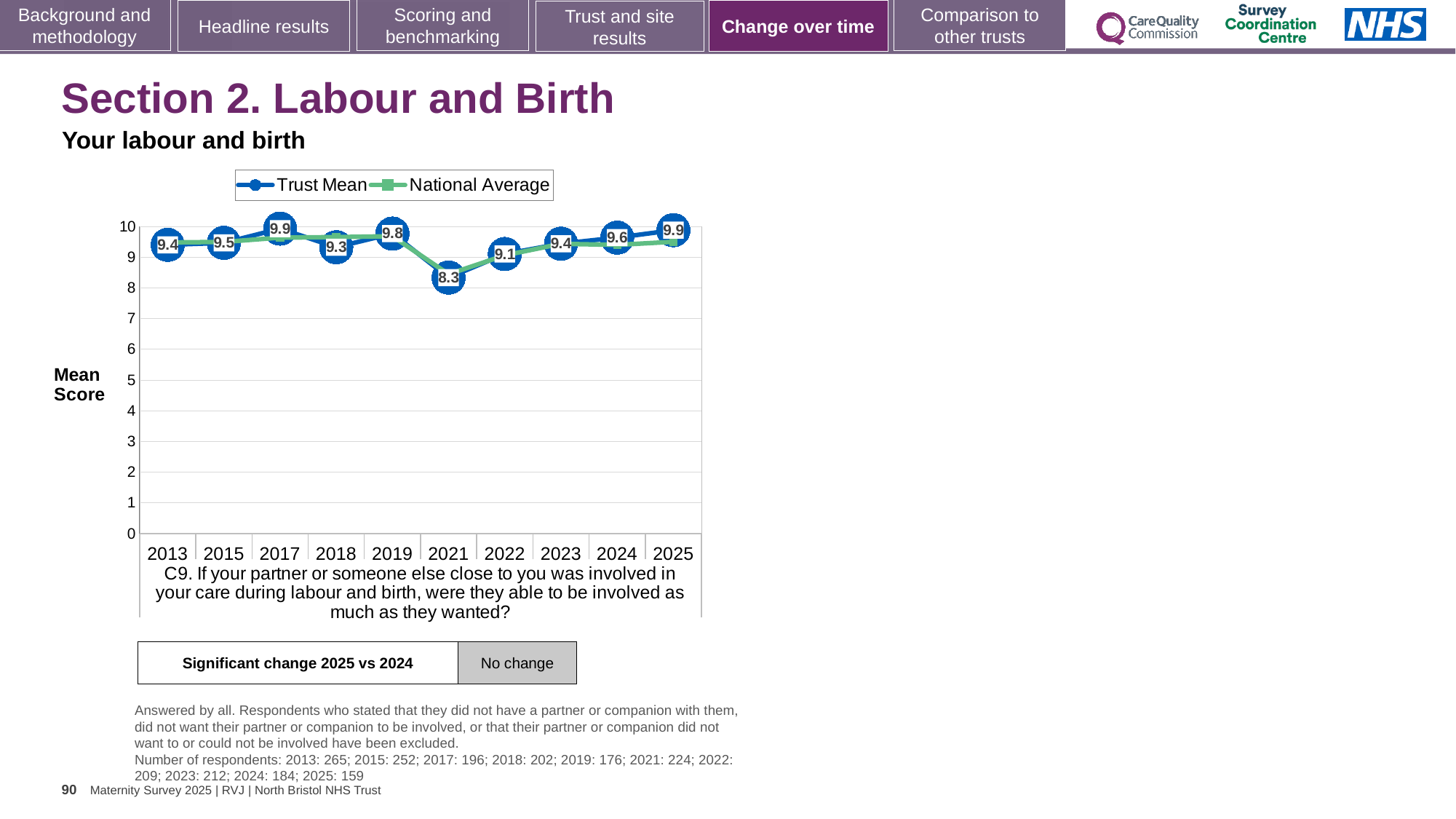
What is the difference between the Trust Mean scores for 2019 and 2021? 1.5 Is the Trust Mean score for 2021 greater or less than 9? less What is the Trust Mean score for 2018? 9.3 What is the Trust Mean score for 2025? 9.9 What is the Trust Mean score for 2021? 8.3 In which year is the Trust Mean score lowest? 2021 What is the difference between the Trust Mean scores for 2025 and 2024? 0.3 How many series does the legend list? 2 How many years are plotted on the x axis? 10 Which year has the larger Trust Mean score, 2022 or 2023? 2023 What is the highest Trust Mean score shown on the chart? 9.9 What kind of chart is shown on the slide? Line chart